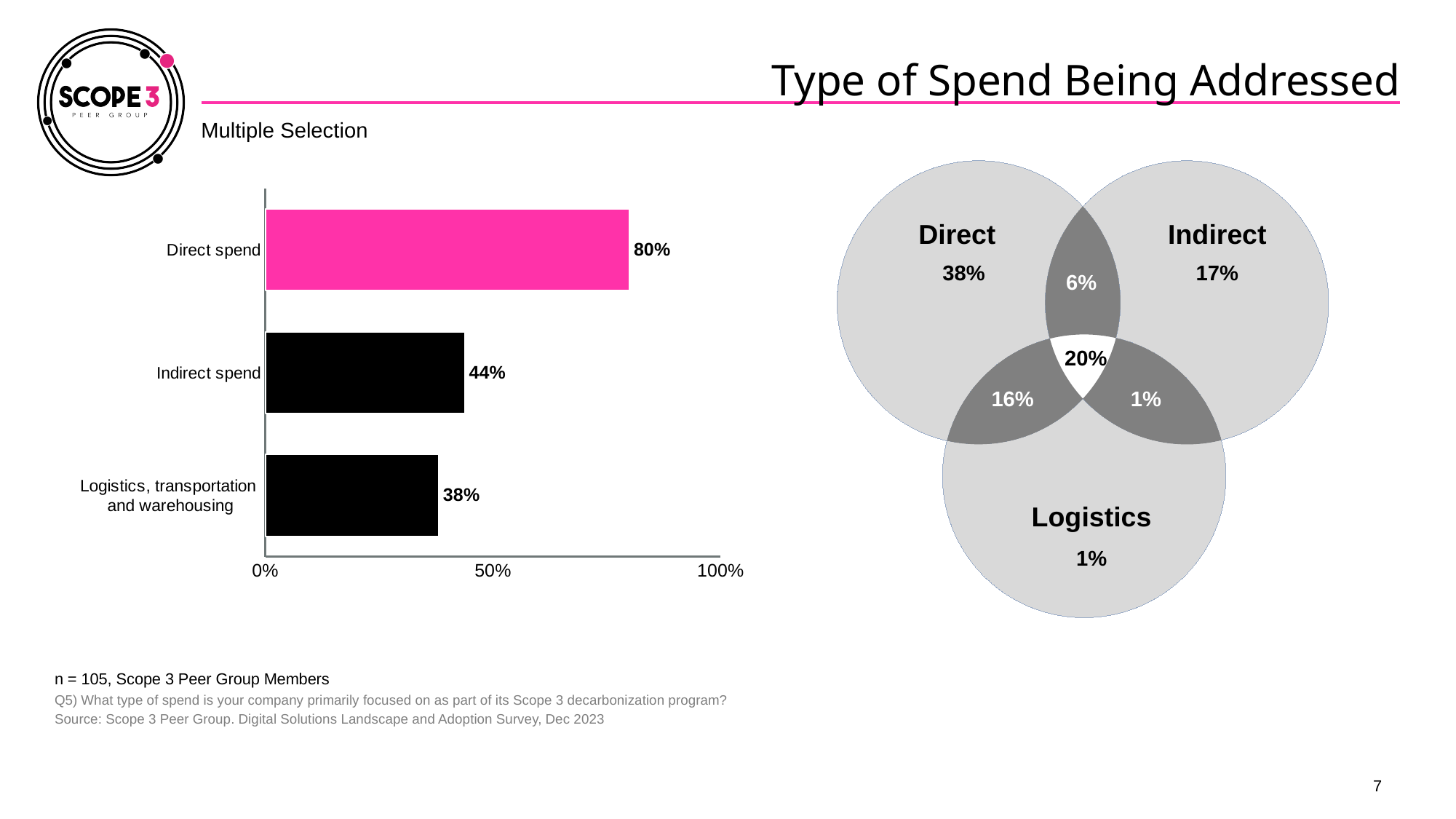
In the bar chart, which is larger: Indirect spend or Logistics, transportation and warehousing? Indirect spend In the bar chart, which category has the lowest value? Logistics, transportation and warehousing In the Venn diagram, what percentage is shown in the overlap of all three circles (Direct, Indirect and Logistics)? 20% How many categories are shown in the bar chart? 3 In the bar chart, which category has the highest value? Direct spend What kind of chart is on the left side of the slide? bar chart In the bar chart, what is the value for Indirect spend? 44% In the bar chart, what is the difference between Direct spend and Indirect spend? 36% In the bar chart, what is the value for Logistics, transportation and warehousing? 38% In the bar chart, what is the value for Direct spend? 80% In the bar chart, is the value for Direct spend greater or less than 50%? greater In the bar chart, which bar is coloured pink? Direct spend